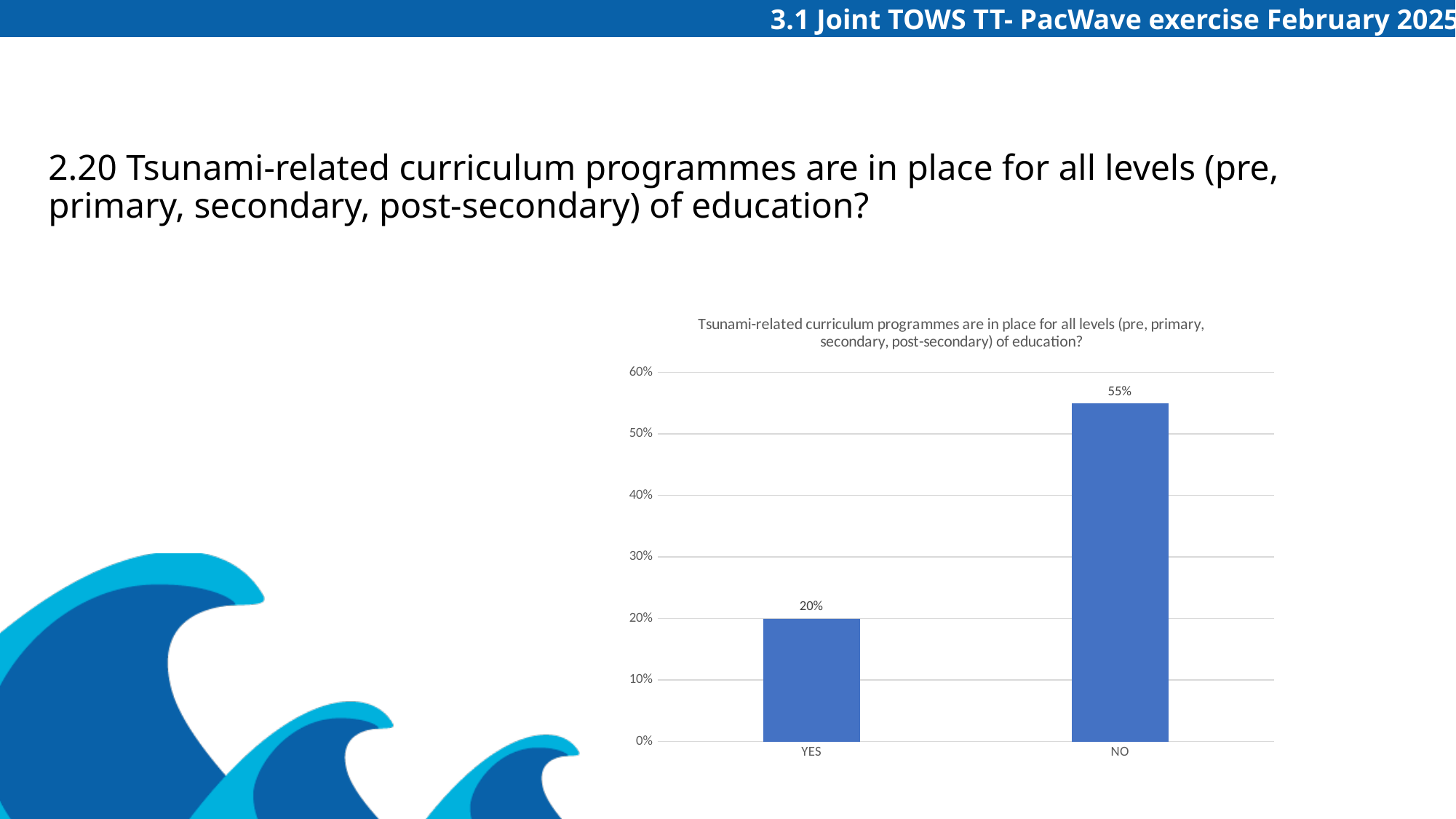
What is the title of the chart? Tsunami-related curriculum programmes are in place for all levels (pre, primary, secondary, post-secondary) of education? What is the value for NO? 55% Is the value for YES greater or less than 30%? less What kind of chart is shown on the slide? bar chart What is the highest value shown on the y axis? 60% Which category has the highest value? NO What is the difference between the values for NO and YES? 35% Is the value for NO greater or less than 50%? greater How many categories are shown on the x axis? 2 Which category has the lowest value? YES What is the value for YES? 20% Which is larger, the value for YES or the value for NO? NO